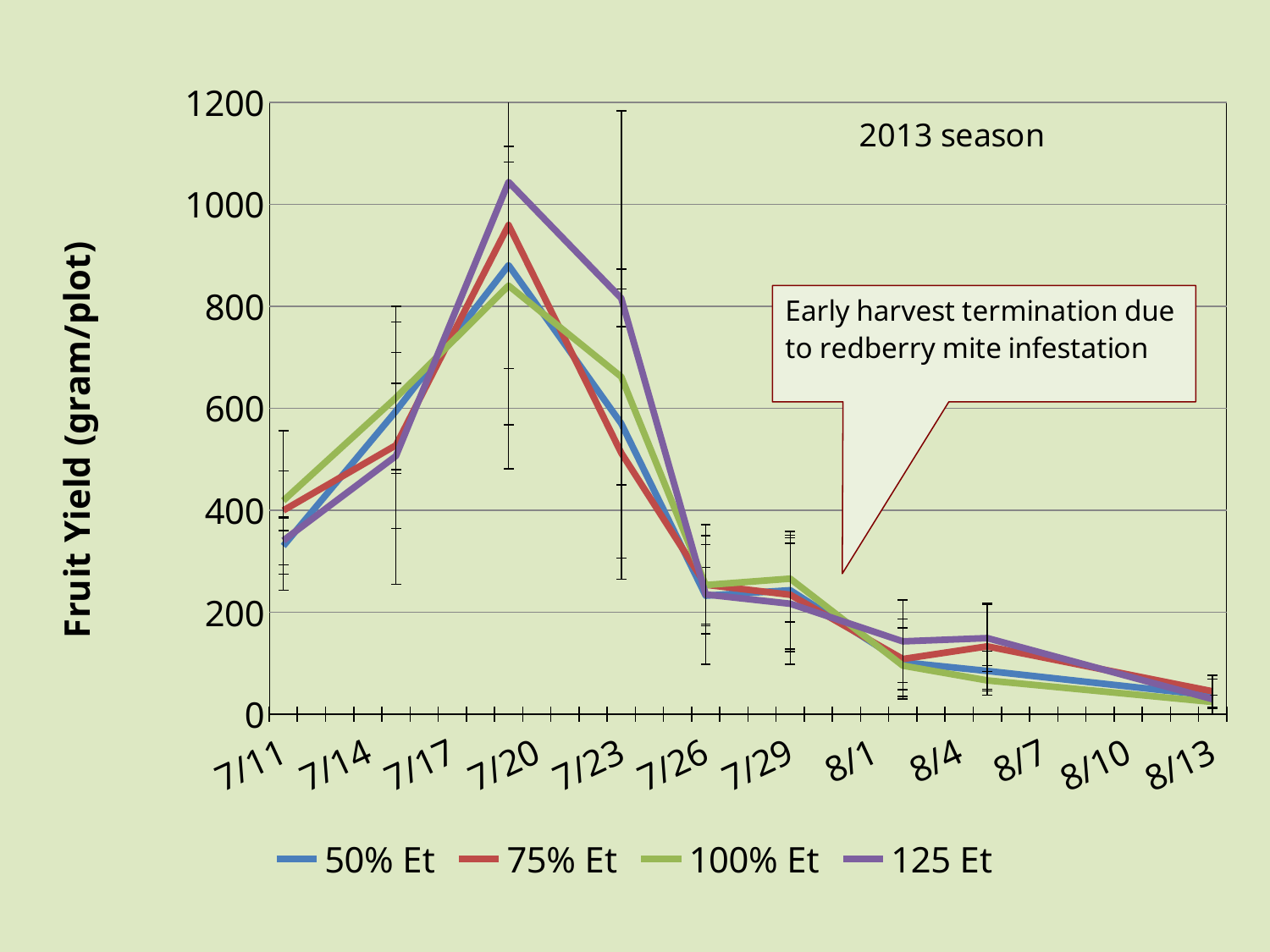
Which series reaches the highest fruit yield at 7/20? 125 Et Is the value for 125 Et at 7/20 greater or less than 1000? greater Is the value for 50% Et at 7/20 greater or less than 800? greater At 7/20, which is larger: the value for 75% Et or the value for 100% Et? 75% Et At 7/20, which is larger: the value for 125 Et or the value for 50% Et? 125 Et How many series does the legend list? 4 What is the title of the y axis? Fruit Yield (gram/plot) Is the value for 50% Et at 7/11 greater or less than 400? less Do the fruit yield values rise or fall along the x axis from 7/20 to 8/13? fall What kind of chart is shown on the slide? line chart